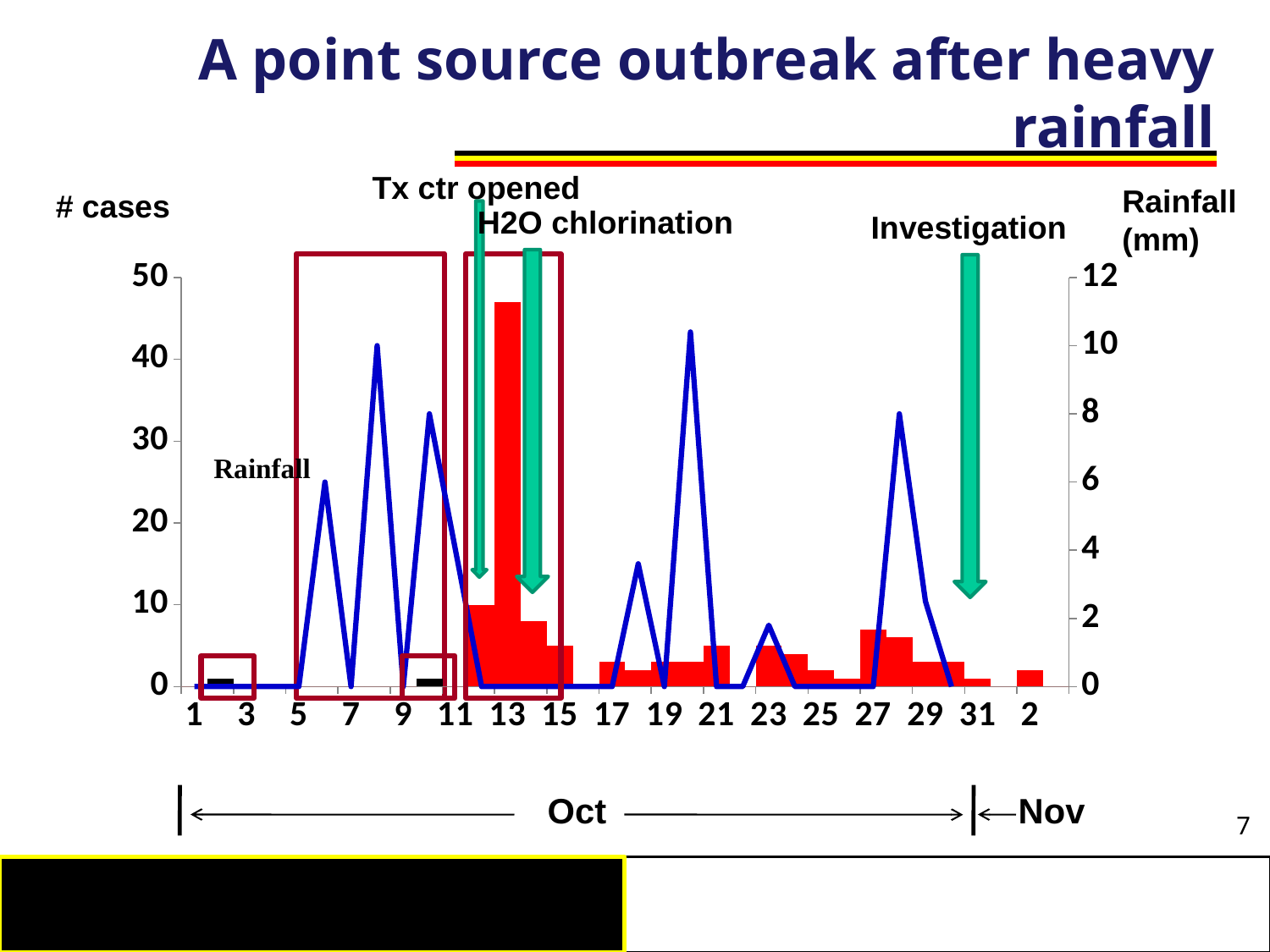
What is the label of the left-hand vertical axis? # cases Is the rainfall on day 6 greater or less than 4 mm? greater Is the number of cases on day 14 greater or less than 10? less Which day has more cases, day 13 or day 20? Day 13 On which day is the number of cases (red bars) highest? 13 Is the rainfall on day 8 greater or less than 8 mm? greater What is the label of the right-hand vertical axis? Rainfall (mm) Do the number of cases rise or fall from day 13 to day 15? Fall What kind of chart is shown on the slide? A combined bar and line chart